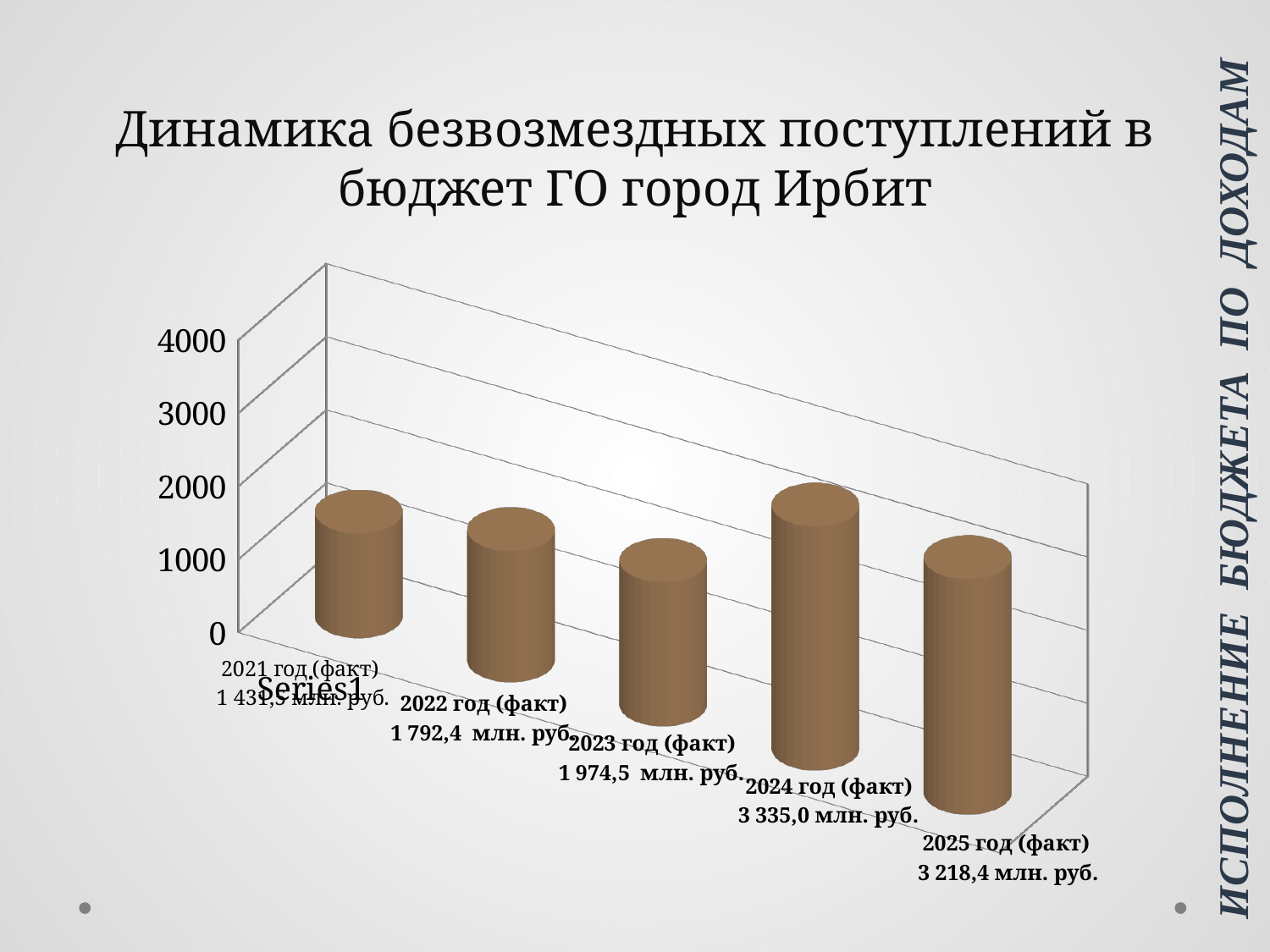
What is the difference between the values for 2024 год (факт) and 2025 год (факт)? 116,6 млн. руб. Which is larger, the value for 2024 год (факт) or 2025 год (факт)? 2024 год (факт) What is the value for 2024 год (факт)? 3 335,0 млн. руб. What is the value for 2025 год (факт)? 3 218,4 млн. руб. Is the value for 2024 год (факт) greater or less than 3000? greater Which year has the highest value? 2024 год (факт) What kind of chart is shown on the slide? bar chart How many categories (years) are shown in the chart? 5 What is the value for 2022 год (факт)? 1 792,4 млн. руб. What is the difference between the values for 2023 год (факт) and 2022 год (факт)? 182,1 млн. руб. What is the value for 2023 год (факт)? 1 974,5 млн. руб. What is the title of the chart? Динамика безвозмездных поступлений в бюджет ГО город Ирбит